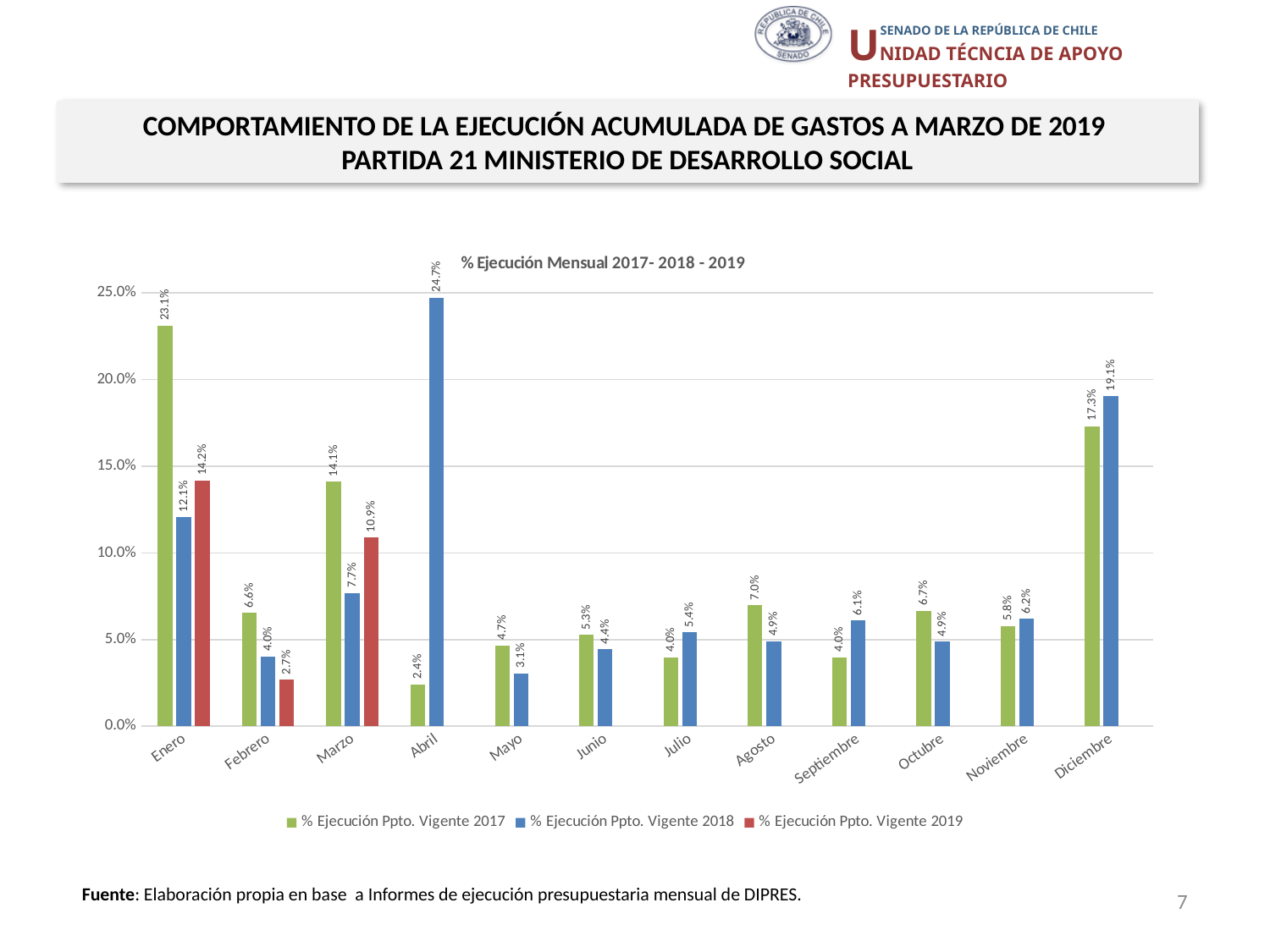
How many series does the legend list? 3 Which is larger in Febrero: the 2017 value or the 2019 value? 2017 value (6.6%) What is the difference between the 2017 and 2018 values in Enero? 11.0% Which month has the highest value for % Ejecución Ppto. Vigente 2017? Enero How many months are shown on the x axis? 12 Is the value for % Ejecución Ppto. Vigente 2018 in Diciembre greater or less than 15.0%? greater What is the value for % Ejecución Ppto. Vigente 2019 in Marzo? 10.9% What is the title of the chart? % Ejecución Mensual 2017- 2018 - 2019 What is the value for % Ejecución Ppto. Vigente 2017 in Diciembre? 17.3% What is the value for % Ejecución Ppto. Vigente 2018 in Abril? 24.7% Which month has the lowest value for % Ejecución Ppto. Vigente 2018? Mayo What kind of chart is shown on the slide? Bar chart